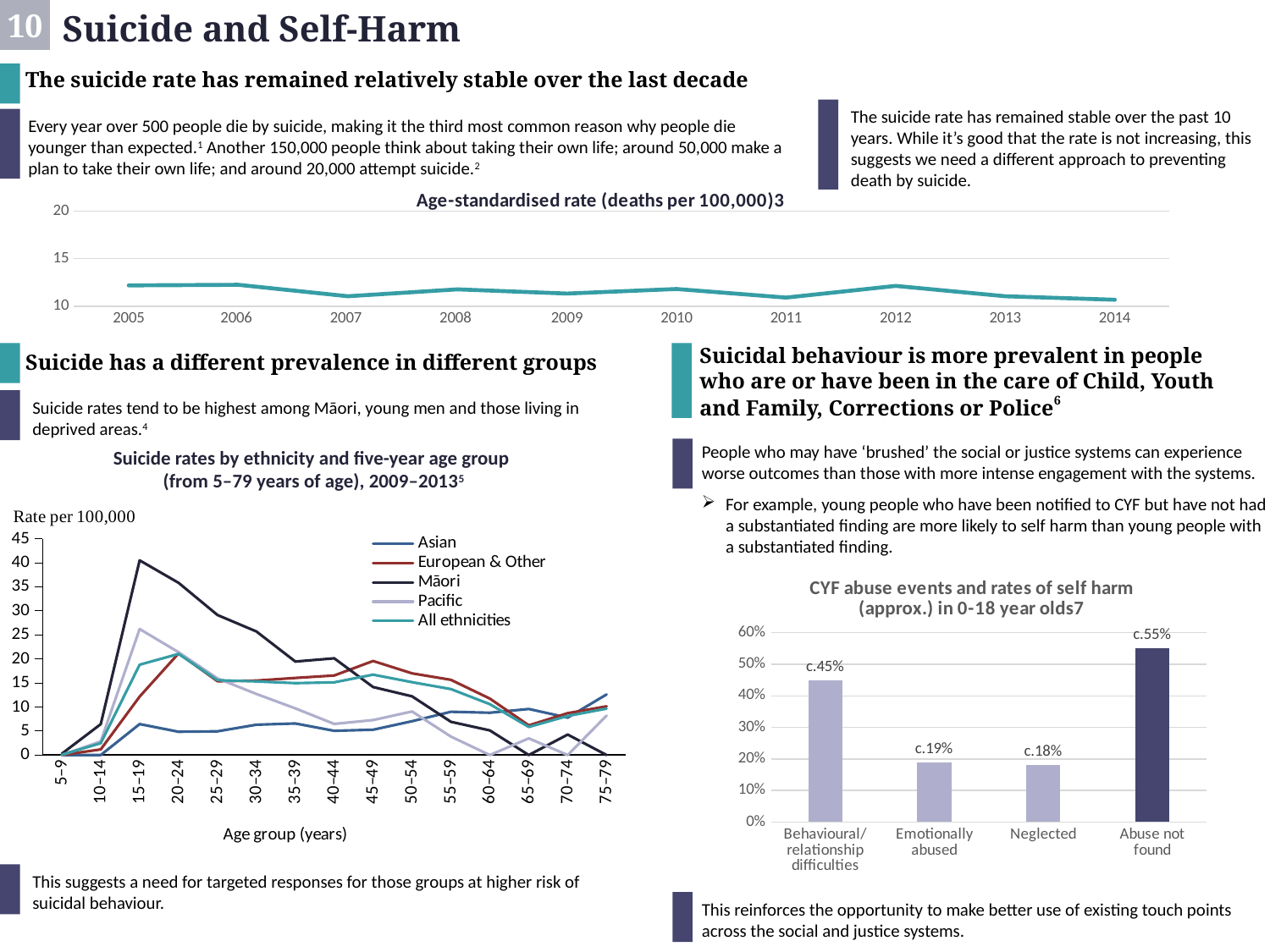
In the chart 'Suicide rates by ethnicity and five-year age group', which series reaches the highest value on the chart? Māori In the chart 'Suicide rates by ethnicity and five-year age group', is the value for Māori at age group 15–19 greater or less than 35? greater In the chart 'CYF abuse events and rates of self harm (approx.) in 0-18 year olds', what is the value for 'Abuse not found'? c.55% In the chart 'Age-standardised rate (deaths per 100,000)', is the value for 2012 greater or less than 15? less How many series does the legend list in the chart 'Suicide rates by ethnicity and five-year age group (from 5–79 years of age), 2009–2013'? 5 What kind of chart is 'CYF abuse events and rates of self harm (approx.) in 0-18 year olds'? Bar chart How many years are shown on the x axis of the chart 'Age-standardised rate (deaths per 100,000)'? 10 In the chart 'CYF abuse events and rates of self harm (approx.) in 0-18 year olds', what is the value for 'Emotionally abused'? c.19% In the chart 'CYF abuse events and rates of self harm (approx.) in 0-18 year olds', which category has the highest value? Abuse not found In the chart 'CYF abuse events and rates of self harm (approx.) in 0-18 year olds', which category has the lowest value? Neglected How many categories are shown in the chart 'CYF abuse events and rates of self harm (approx.) in 0-18 year olds'? 4 In the chart 'CYF abuse events and rates of self harm (approx.) in 0-18 year olds', which is larger: 'Behavioural/relationship difficulties' or 'Emotionally abused'? Behavioural/relationship difficulties